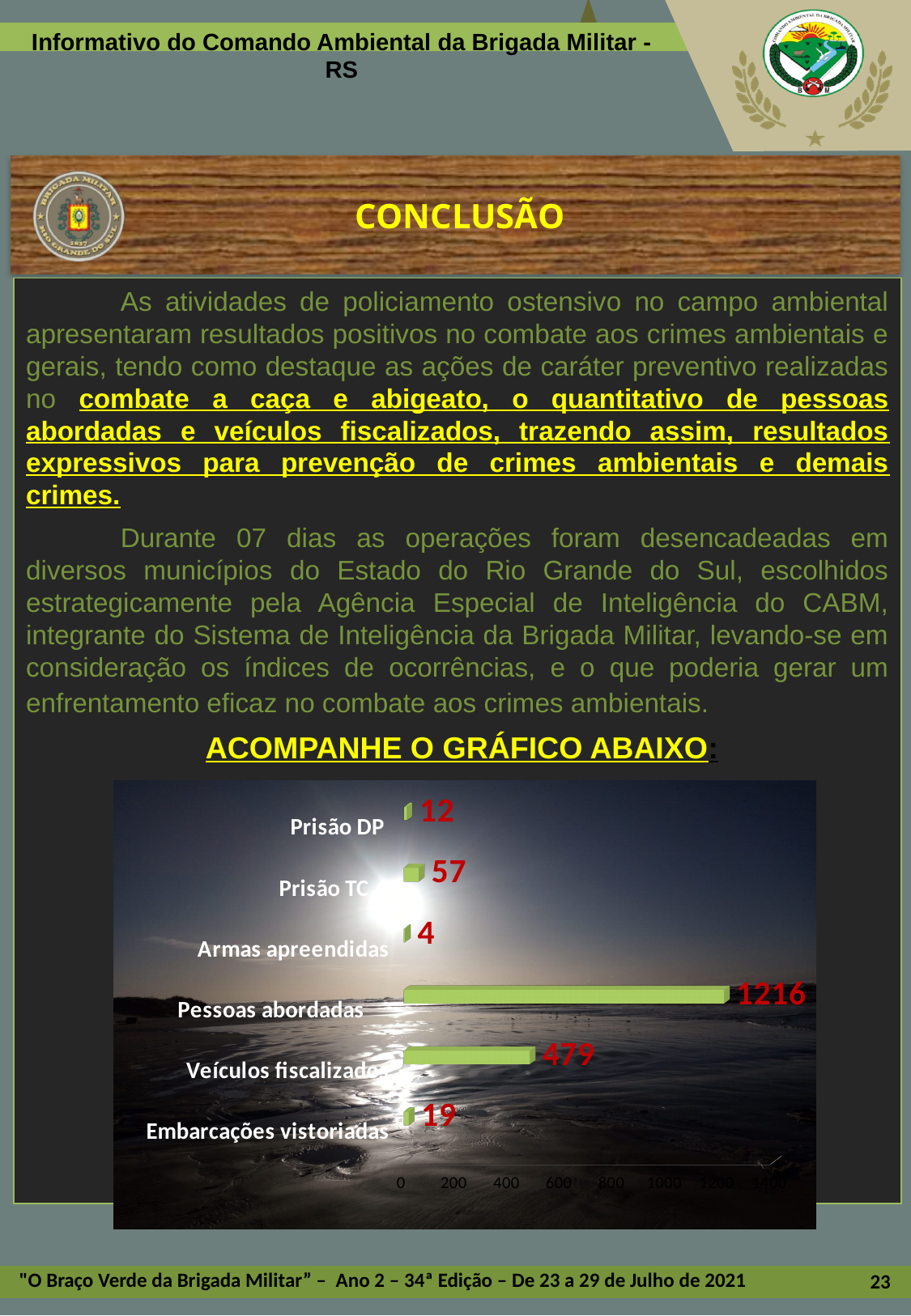
What is the value for Embarcações vistoriadas? 19 Which is larger, Prisão TC or Prisão DP? Prisão TC Which category has the lowest value? Armas apreendidas What is the value for Pessoas abordadas? 1216 Which category has the highest value? Pessoas abordadas Is the value for Veículos fiscalizados greater or less than 400? greater What kind of chart is shown on the slide? bar chart What is the difference between Prisão TC and Prisão DP? 45 What is the difference between Pessoas abordadas and Veículos fiscalizados? 737 How many categories are shown in the chart? 6 What is the value for Prisão TC? 57 What is the value for Veículos fiscalizados? 479